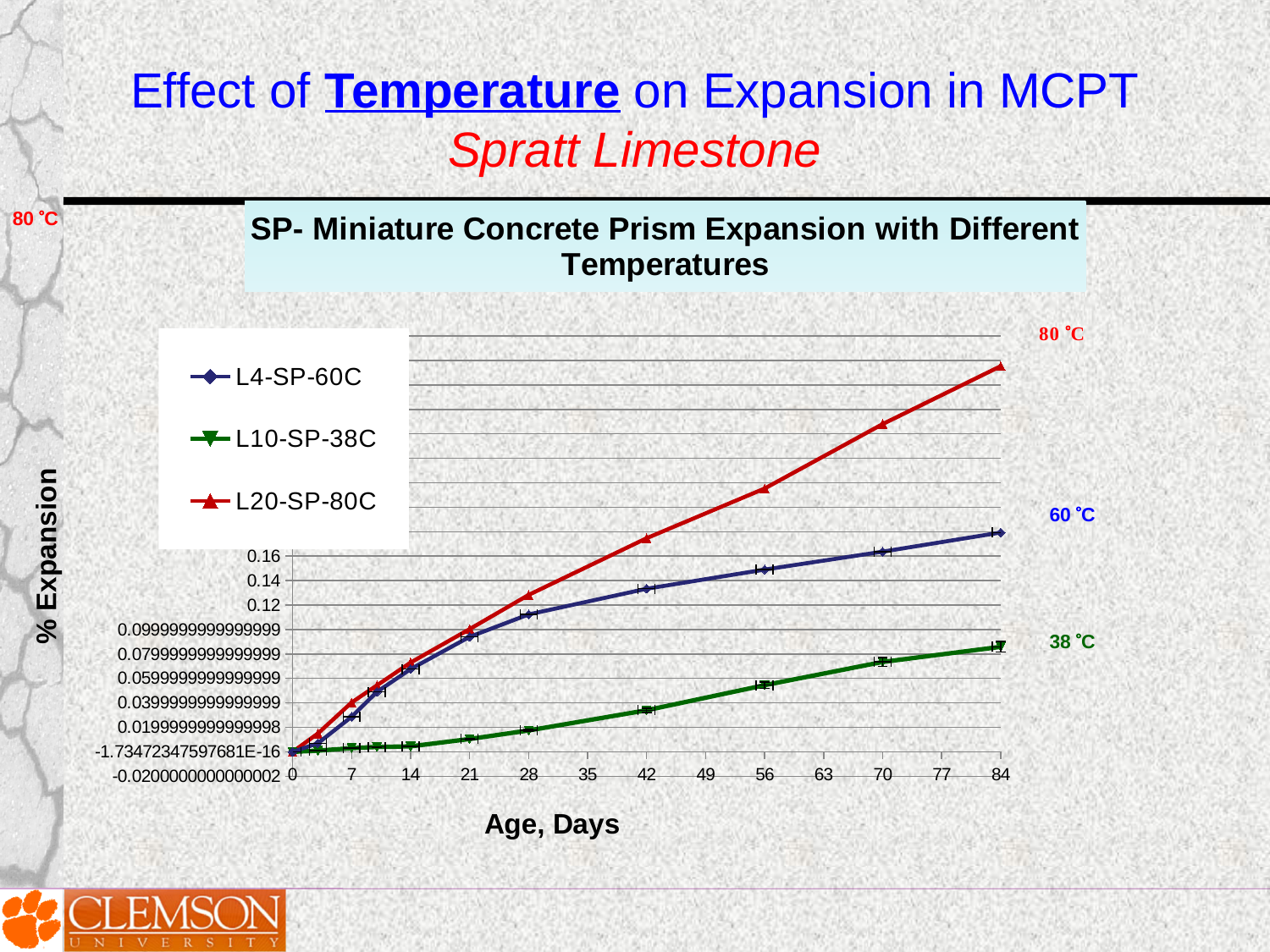
How many tick marks are labelled on the x axis? 13 Is the value for L20-SP-80C at 14 days greater or less than 0.1? less How many series does the legend list? 3 Is the value for L10-SP-38C at 84 days greater or less than 0.06? greater Which series has the lowest expansion at 84 days? L10-SP-38C Which series has the highest expansion at 84 days? L20-SP-80C What kind of chart is shown on the slide? line chart Do the values for L20-SP-80C rise or fall as age increases? rise What is the title of the chart? SP- Miniature Concrete Prism Expansion with Different Temperatures At 70 days, which series has the larger expansion, L4-SP-60C or L10-SP-38C? L4-SP-60C What is the label of the x axis? Age, Days Is the value for L4-SP-60C at 42 days greater or less than 0.12? greater